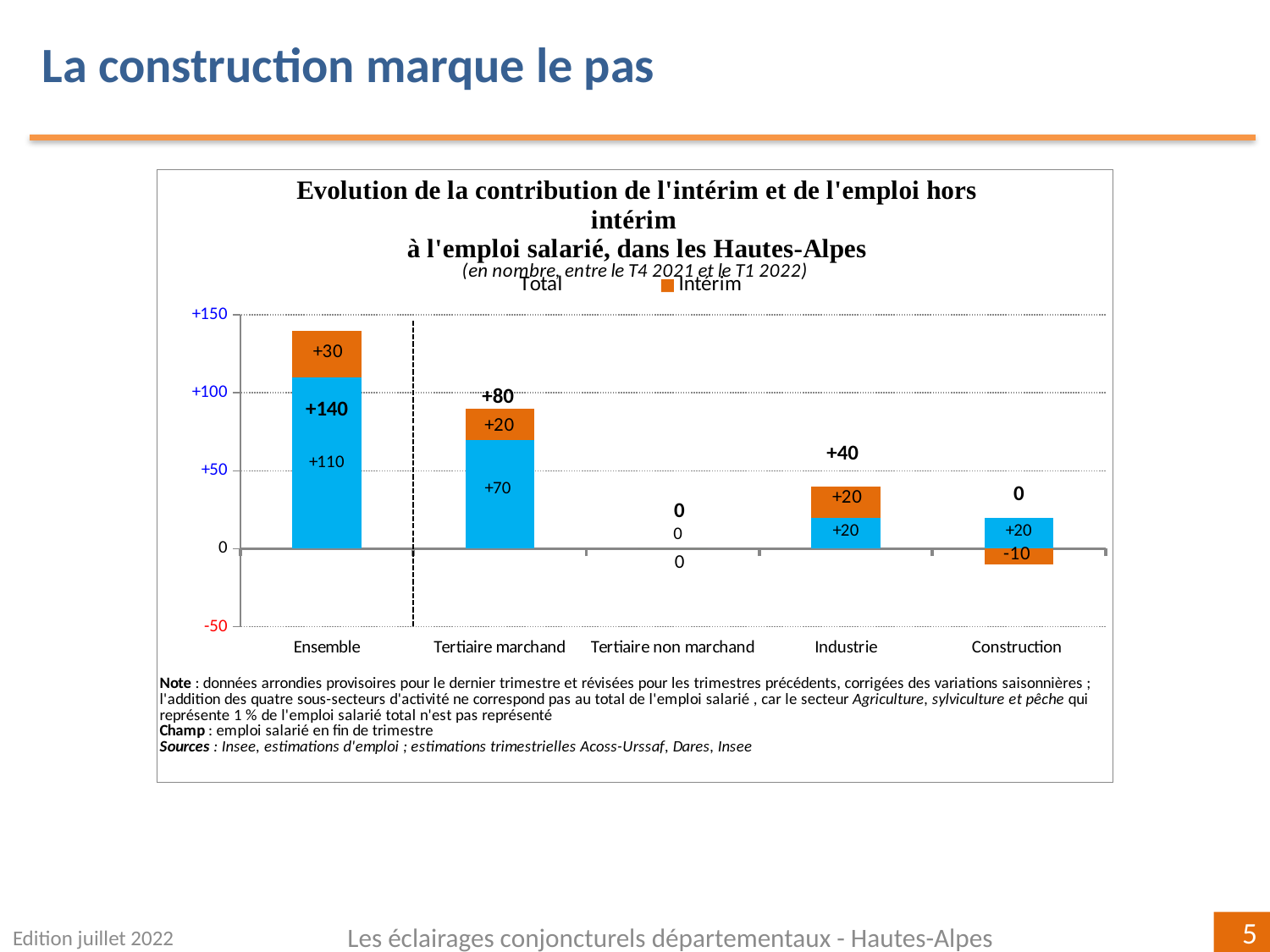
What is the total value shown above the Ensemble bar? +140 What is the Intérim (orange) value for Tertiaire marchand? +20 How many categories are shown on the x axis of the chart? 5 What is the Intérim (orange) value for Construction? -10 What type of chart is shown on the slide? Stacked bar chart Which is larger, the blue segment for Tertiaire marchand or the blue segment for Industrie? Tertiaire marchand What is the total value shown for Tertiaire non marchand? 0 What is the difference between the total for Ensemble and the total for Tertiaire marchand? 60 What is the total value shown for Industrie? +40 Which category has the highest total value? Ensemble What is the blue segment value for Ensemble? +110